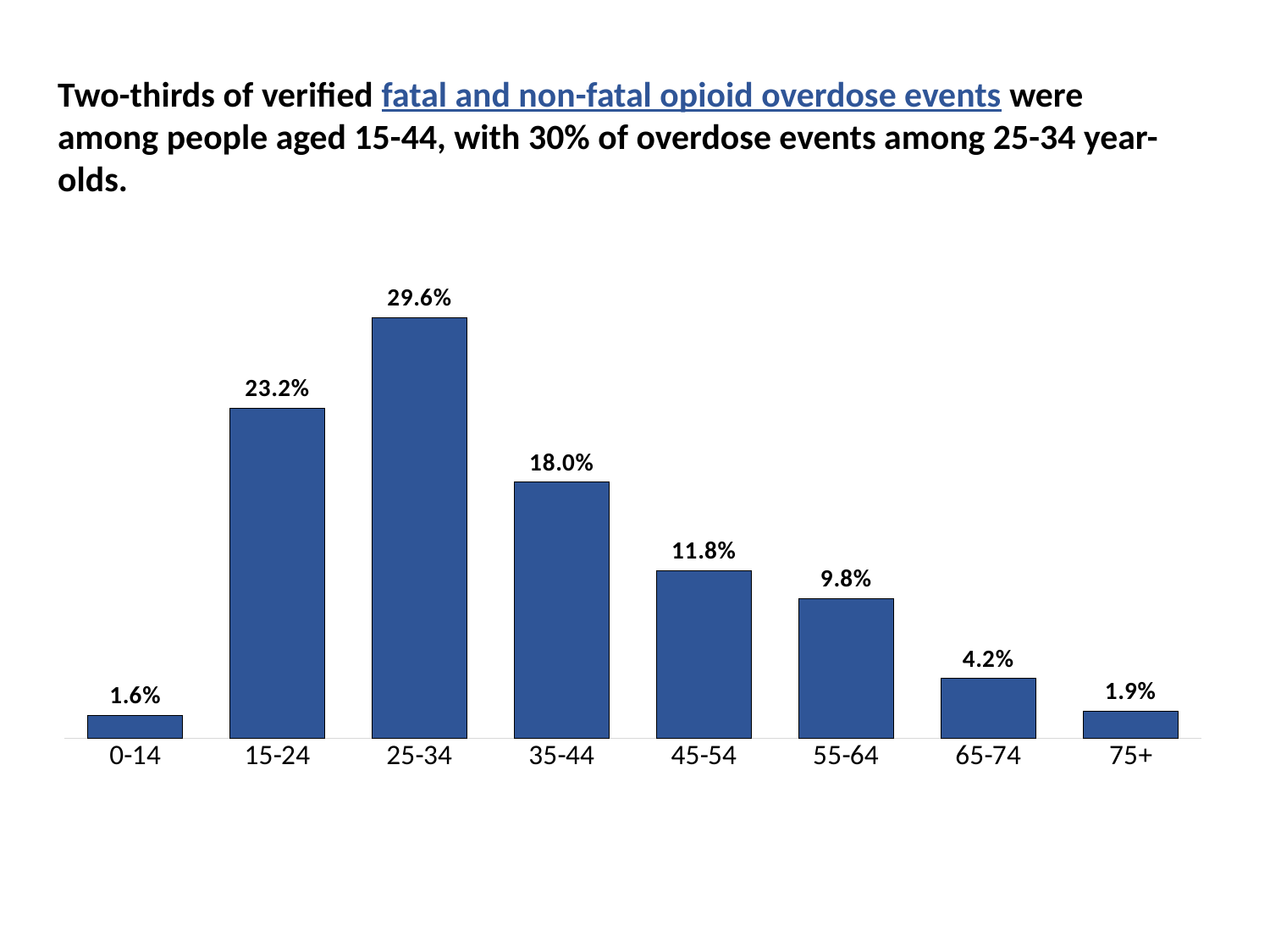
What percentage of overdose events were among people aged 25-34? 29.6% Which age group has the highest percentage of overdose events? 25-34 What type of chart is shown on the slide? Bar chart What is the difference in percentage points between the 25-34 and 15-24 age groups? 6.4 What is the value shown for the 15-24 age group? 23.2% What is the difference between the values for 35-44 and 45-54? 6.2 What percentage is shown for the 55-64 age group? 9.8% Do the values rise or fall from the 25-34 age group to the 75+ age group? Fall Which has a larger value, the 65-74 age group or the 75+ age group? 65-74 How many age groups are shown on the chart? 8 Which age group has the lowest percentage of overdose events? 0-14 What is the value for the 75+ age group? 1.9%